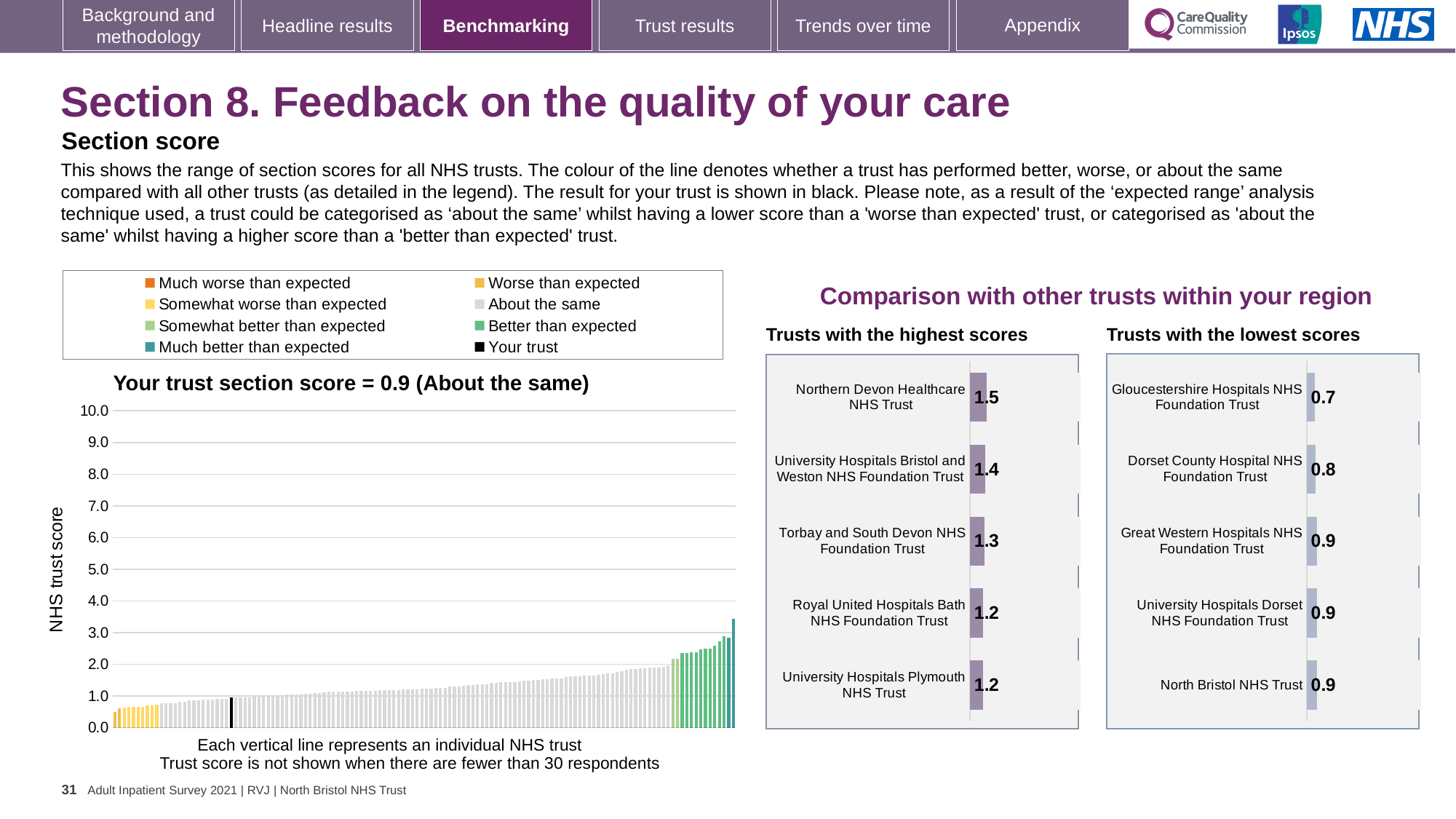
In the 'Trusts with the highest scores' chart, what is the score for Northern Devon Healthcare NHS Trust? 1.5 In the 'Trusts with the lowest scores' chart, which has the larger score: Dorset County Hospital NHS Foundation Trust or Gloucestershire Hospitals NHS Foundation Trust? Dorset County Hospital NHS Foundation Trust In the 'Trusts with the highest scores' chart, which trust has the highest score? Northern Devon Healthcare NHS Trust In the 'Trusts with the lowest scores' chart, what is the score for Gloucestershire Hospitals NHS Foundation Trust? 0.7 In the 'Your trust section score' chart, do the trust scores rise or fall from left to right along the x axis? rise How many entries does the legend of the 'Your trust section score' chart list? 8 In the 'Trusts with the lowest scores' chart, what is the difference between the scores of North Bristol NHS Trust and Gloucestershire Hospitals NHS Foundation Trust? 0.2 In the 'Trusts with the highest scores' chart, what is the difference between the scores of Northern Devon Healthcare NHS Trust and University Hospitals Plymouth NHS Trust? 0.3 In the 'Trusts with the lowest scores' chart, which trust has the lowest score? Gloucestershire Hospitals NHS Foundation Trust In the 'Trusts with the highest scores' chart, what is the score for Torbay and South Devon NHS Foundation Trust? 1.3 According to the title of the 'Your trust section score' chart, what is the section score for your trust? 0.9 (About the same) How many trusts are shown in the 'Trusts with the highest scores' chart? 5